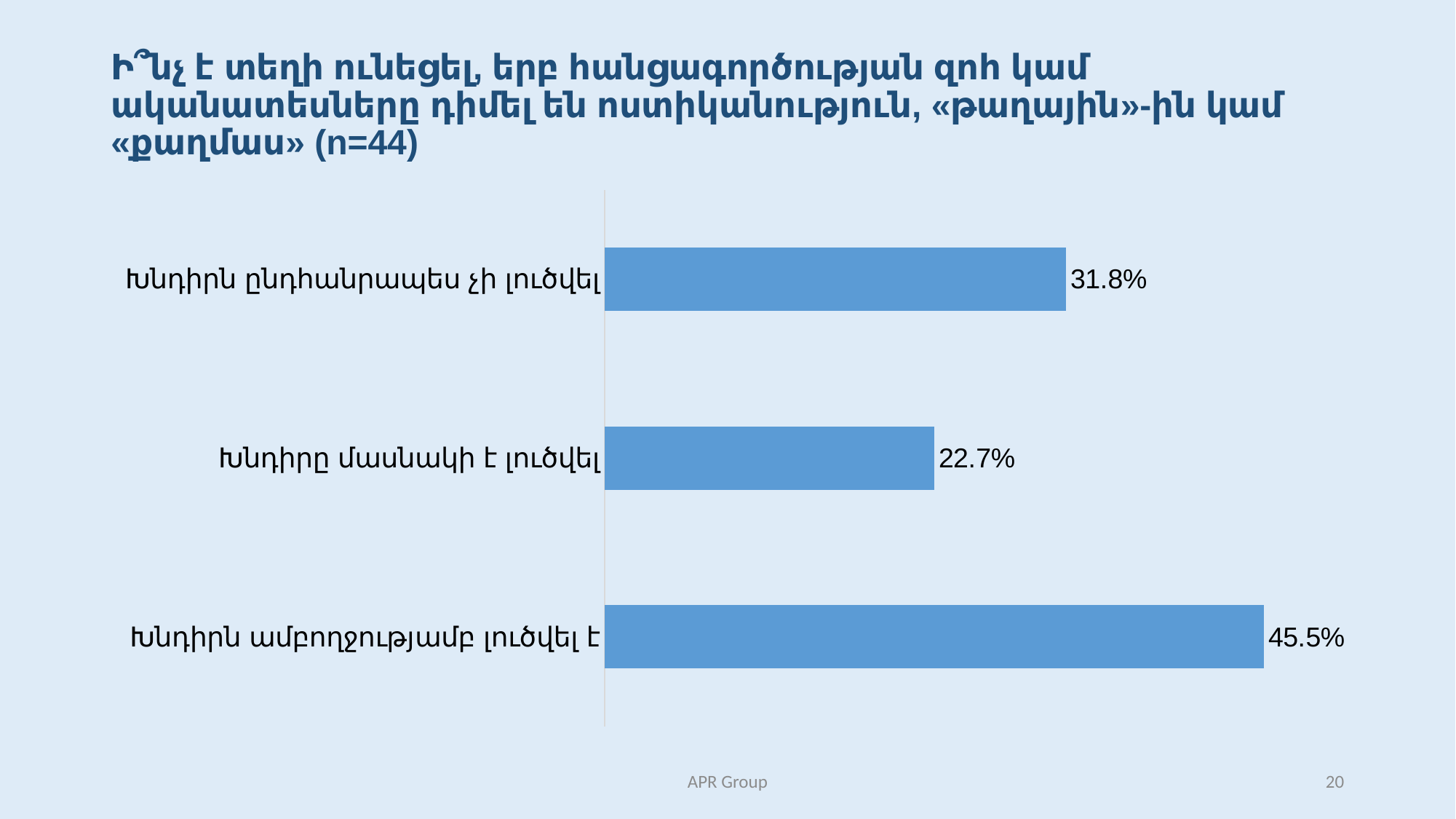
Which category has the lowest value? Խնդիրը մասնակի է լուծվել What is the difference between the values for "Խնդիրն ամբողջությամբ լուծվել է" and "Խնդիրն ընդհանրապես չի լուծվել"? 13.7% What is the sample size (n) stated in the slide title? 44 How many categories are shown in the chart? 3 What is the difference between the values for "Խնդիրն ընդհանրապես չի լուծվել" and "Խնդիրը մասնակի է լուծվել"? 9.1% What is the value for "Խնդիրը մասնակի է լուծվել"? 22.7% What kind of chart is shown on the slide? Bar chart What is the value for "Խնդիրն ընդհանրապես չի լուծվել"? 31.8% What colour are the bars in the chart? Blue Which is larger: the value for "Խնդիրն ընդհանրապես չի լուծվել" or for "Խնդիրը մասնակի է լուծվել"? Խնդիրն ընդհանրապես չի լուծվել What is the value for "Խնդիրն ամբողջությամբ լուծվել է"? 45.5% Which category has the highest value? Խնդիրն ամբողջությամբ լուծվել է